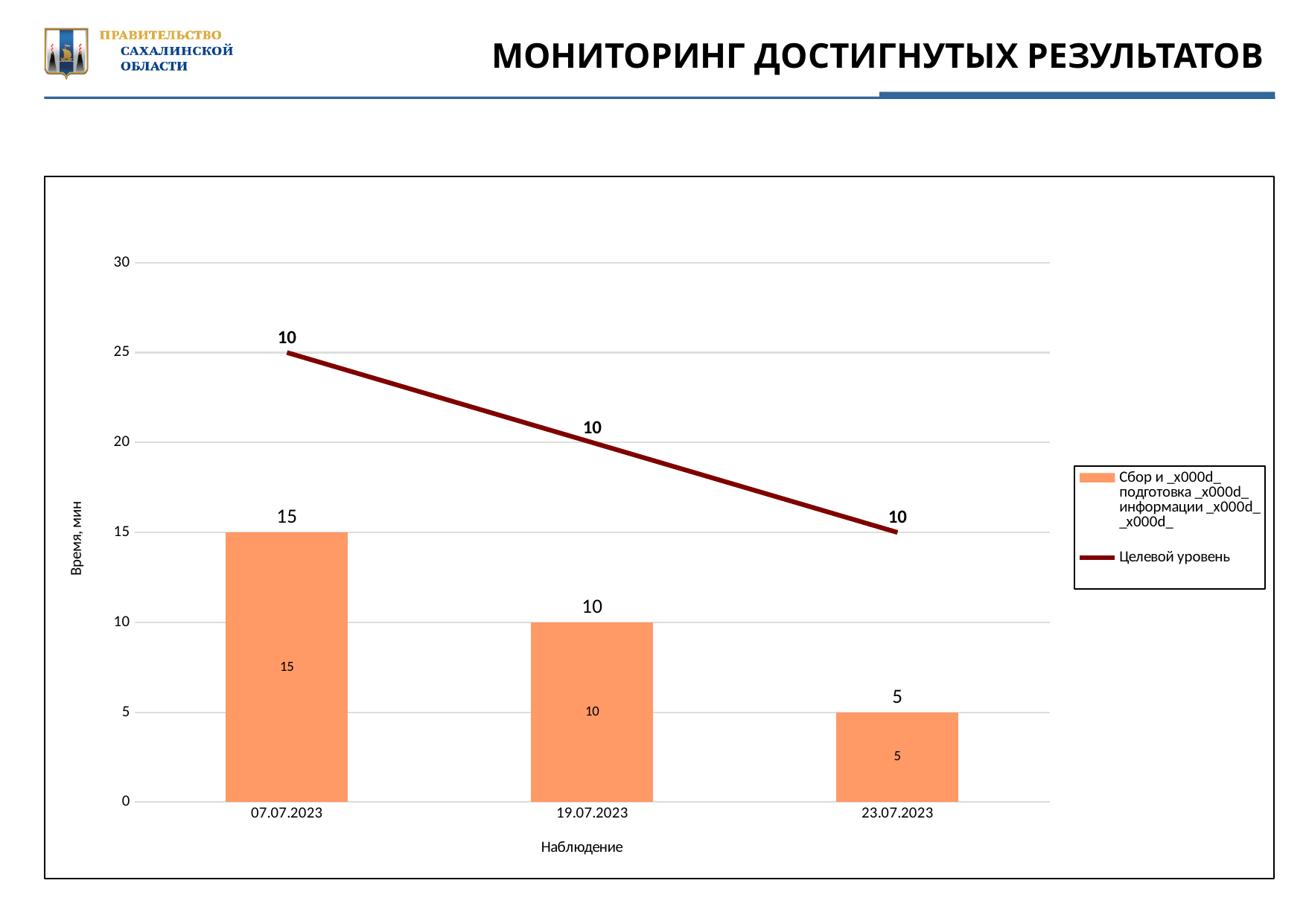
Which bar is larger, 19.07.2023 or 23.07.2023? 19.07.2023 What is the name of the line series in the legend? Целевой уровень Which observation date has the highest bar? 07.07.2023 What is the value of the bar for 07.07.2023? 15 Which observation date has the lowest bar? 23.07.2023 How many observation dates are shown on the x axis? 3 What is the value of the bar for 19.07.2023? 10 Do the bar values rise or fall from left to right along the x axis? fall What is the difference between the bar values for 07.07.2023 and 23.07.2023? 10 What is the label of the y axis? Время, мин What is the value of the bar for 23.07.2023? 5 How many series does the legend list? 2